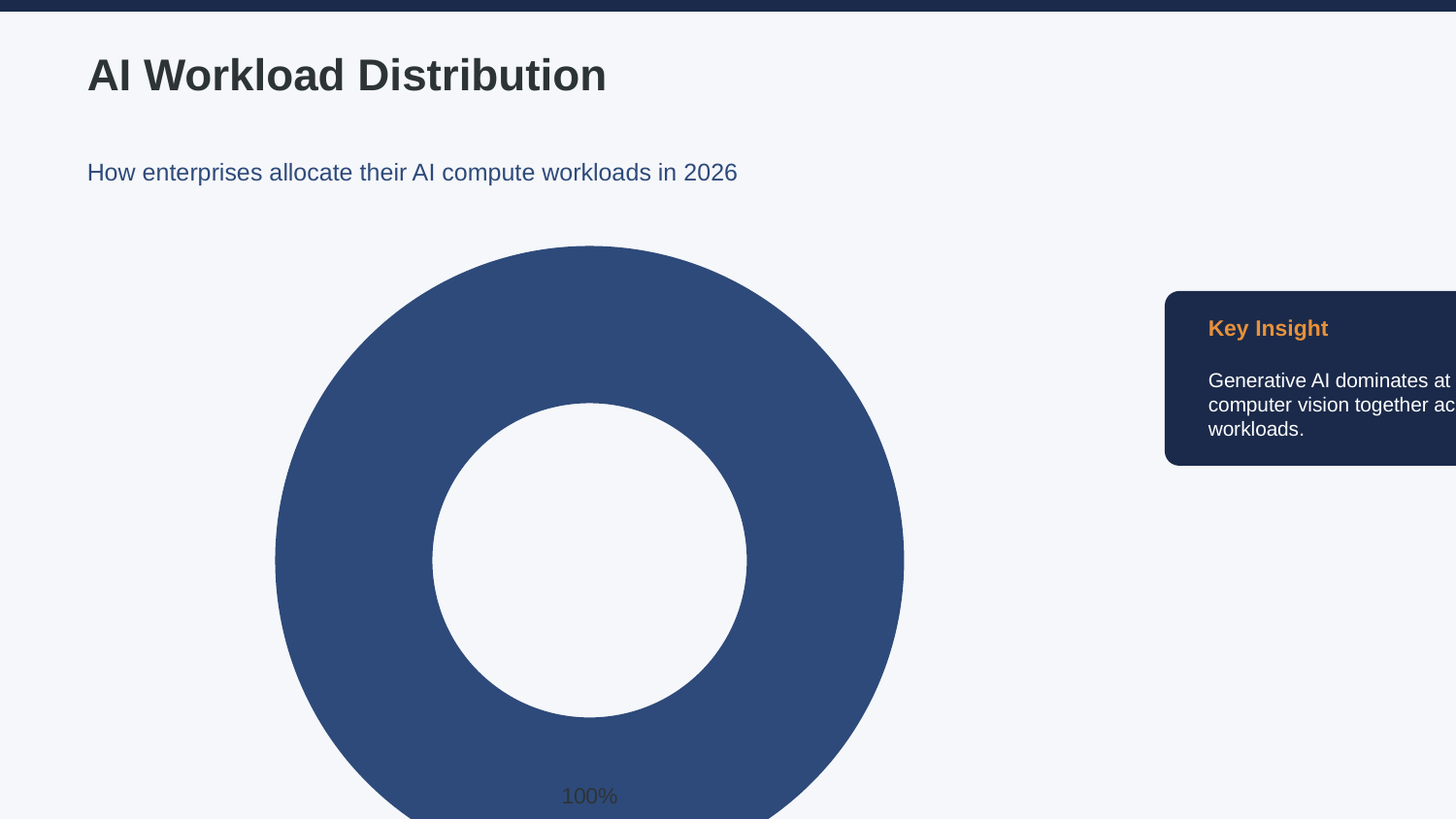
What kind of chart is shown on the slide? doughnut chart What share of the doughnut does the single visible slice take up? 100% How many slices does the doughnut chart show? 1 What is the title of the slide containing the chart? AI Workload Distribution What percentage value is printed as the data label on the doughnut chart? 100% What colour is the slice of the doughnut chart? dark blue